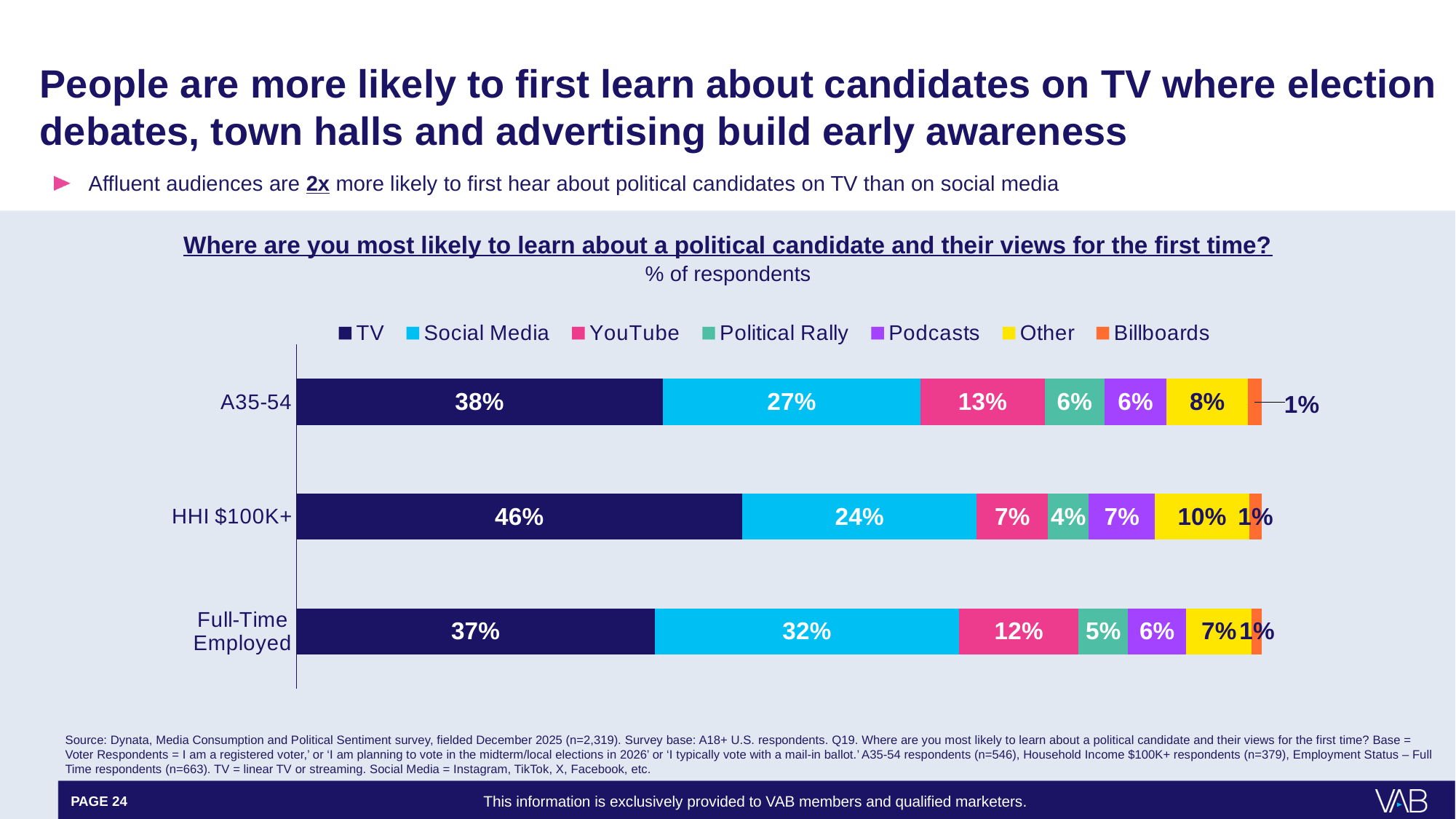
Which series is shown in orange in the legend? Billboards Which group has the highest TV value? HHI $100K+ What is the Other value for HHI $100K+ respondents? 10% Which is larger for the A35-54 group: the Social Media value or the YouTube value? Social Media What is the difference between the TV value and the Social Media value for HHI $100K+ respondents? 22 percentage points What percentage of HHI $100K+ respondents say they are most likely to first learn about a political candidate on TV? 46% What kind of chart is shown on the slide? Stacked bar chart What is the YouTube value for the A35-54 group? 13% What is the Social Media value for Full-Time Employed respondents? 32% How many groups (bars) are shown in the chart? 3 Which group has the lowest Social Media value? HHI $100K+ How many series does the legend list? 7